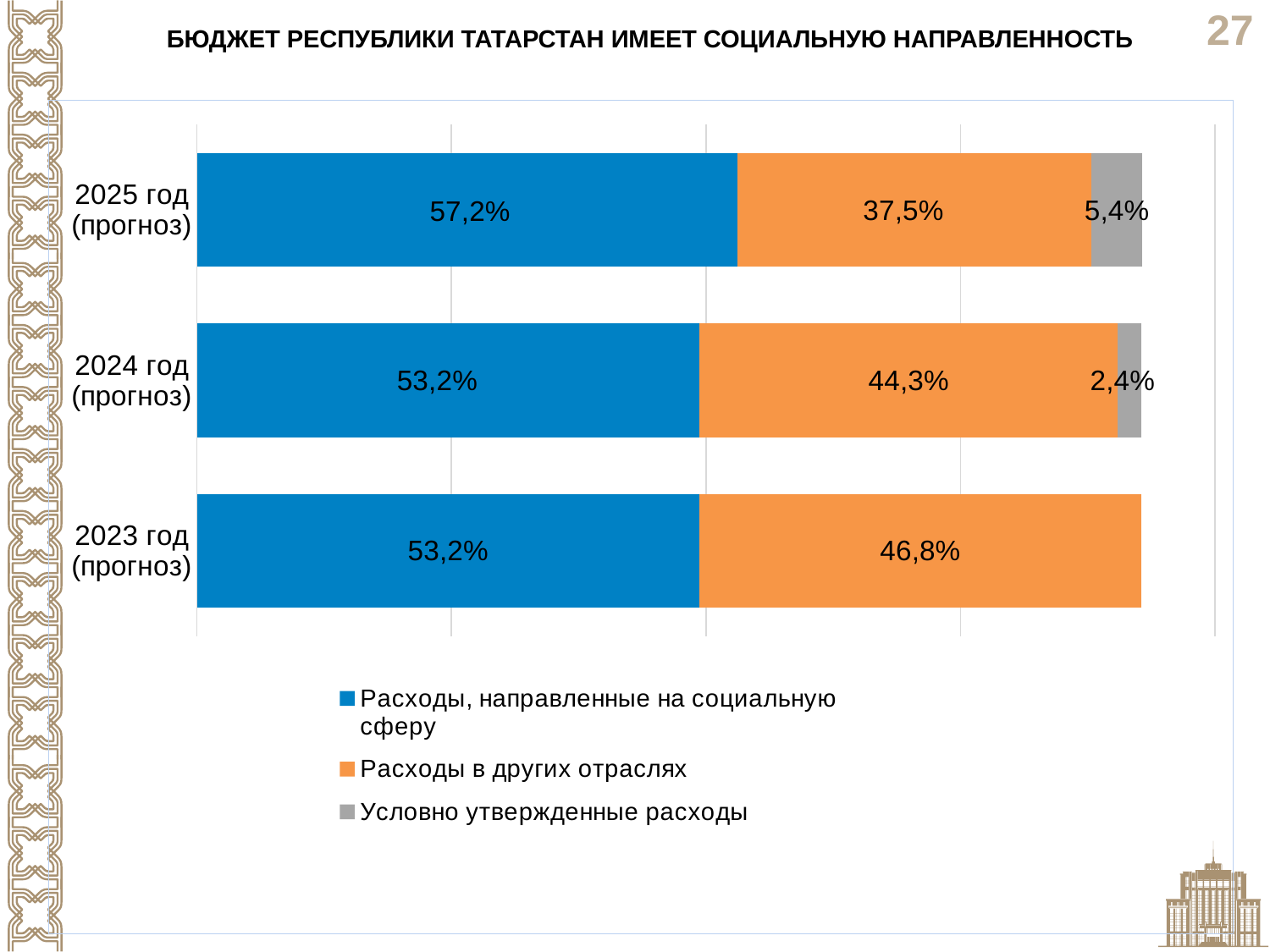
How many series does the legend list? 3 What is the value of Расходы в других отраслях for 2023 год (прогноз)? 46,8% What is the value of Расходы в других отраслях for 2024 год (прогноз)? 44,3% What kind of chart is shown on the slide? Stacked bar chart Which year has the lowest value for Расходы в других отраслях? 2025 год (прогноз) How many year categories are plotted on the chart? 3 What is the value of Расходы, направленные на социальную сферу for 2025 год (прогноз)? 57,2% What is the difference between Расходы, направленные на социальную сферу and Расходы в других отраслях for 2025 год (прогноз)? 19,7% What is the value of Условно утвержденные расходы for 2025 год (прогноз)? 5,4% Which is larger for 2024 год (прогноз): Расходы, направленные на социальную сферу or Расходы в других отраслях? Расходы, направленные на социальную сферу Does the value of Расходы в других отраслях rise or fall from 2023 год (прогноз) to 2025 год (прогноз)? Falls Which year has the highest value for Расходы, направленные на социальную сферу? 2025 год (прогноз)